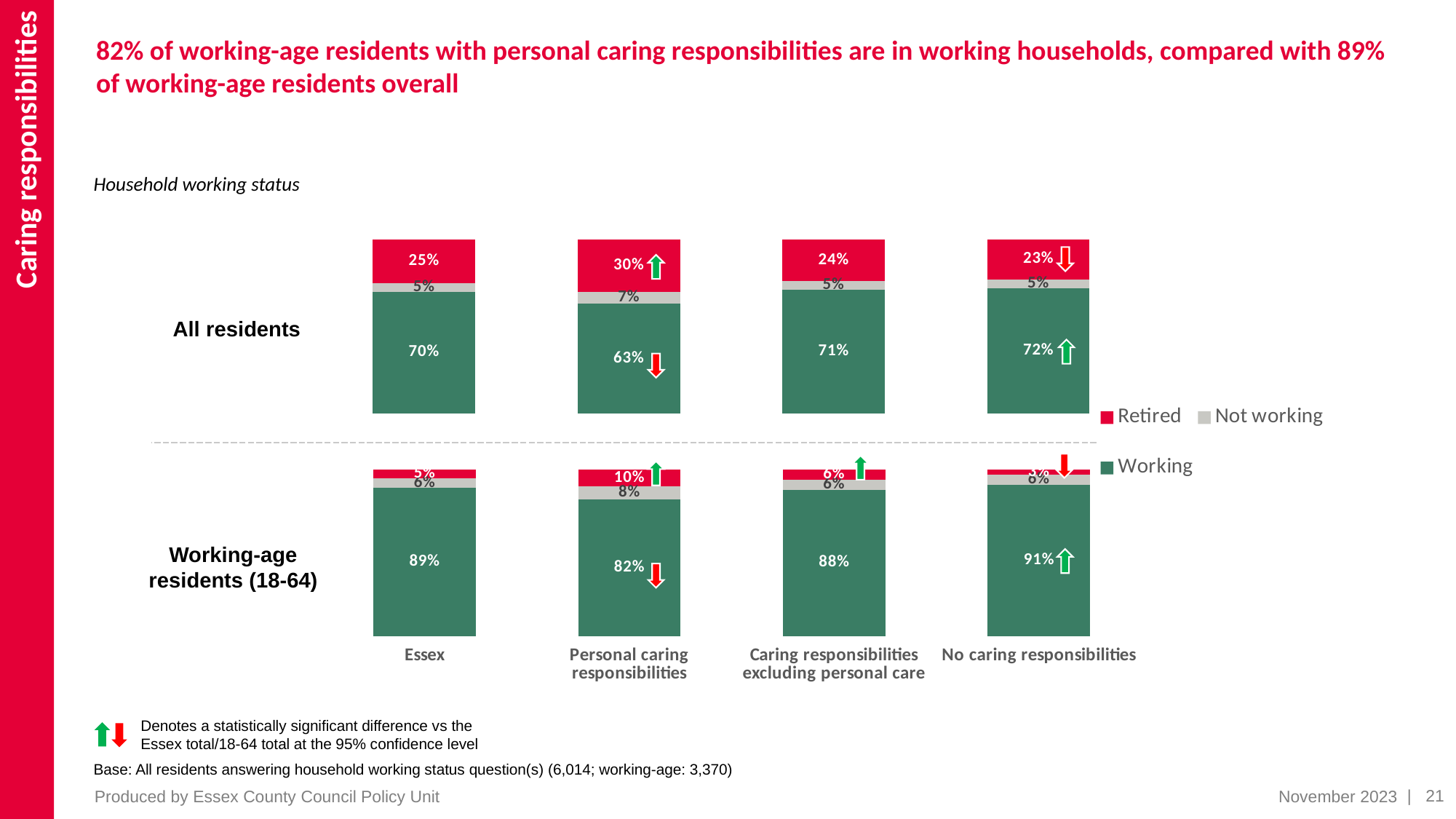
What kind of chart is used on this slide? Stacked bar chart In the Working-age residents (18-64) chart, what is the Not working value for Personal caring responsibilities? 8% In the Working-age residents (18-64) chart, which category has the lowest Working value? Personal caring responsibilities Which series is shown in red in the legend? Retired In the Working-age residents (18-64) chart, what is the Working value for No caring responsibilities? 91% How many series does the legend list? 3 In the All residents chart, what is the difference between the Working value for No caring responsibilities and the Working value for Personal caring responsibilities? 9 percentage points In the Working-age residents (18-64) chart, is the Working value for Essex larger or smaller than the Working value for Caring responsibilities excluding personal care? larger In the All residents chart, what is the Retired value for Essex? 25% How many categories are shown along the x axis of the charts? 4 In the All residents chart, which category has the highest Retired value? Personal caring responsibilities In the All residents chart, what is the Working value for Personal caring responsibilities? 63%